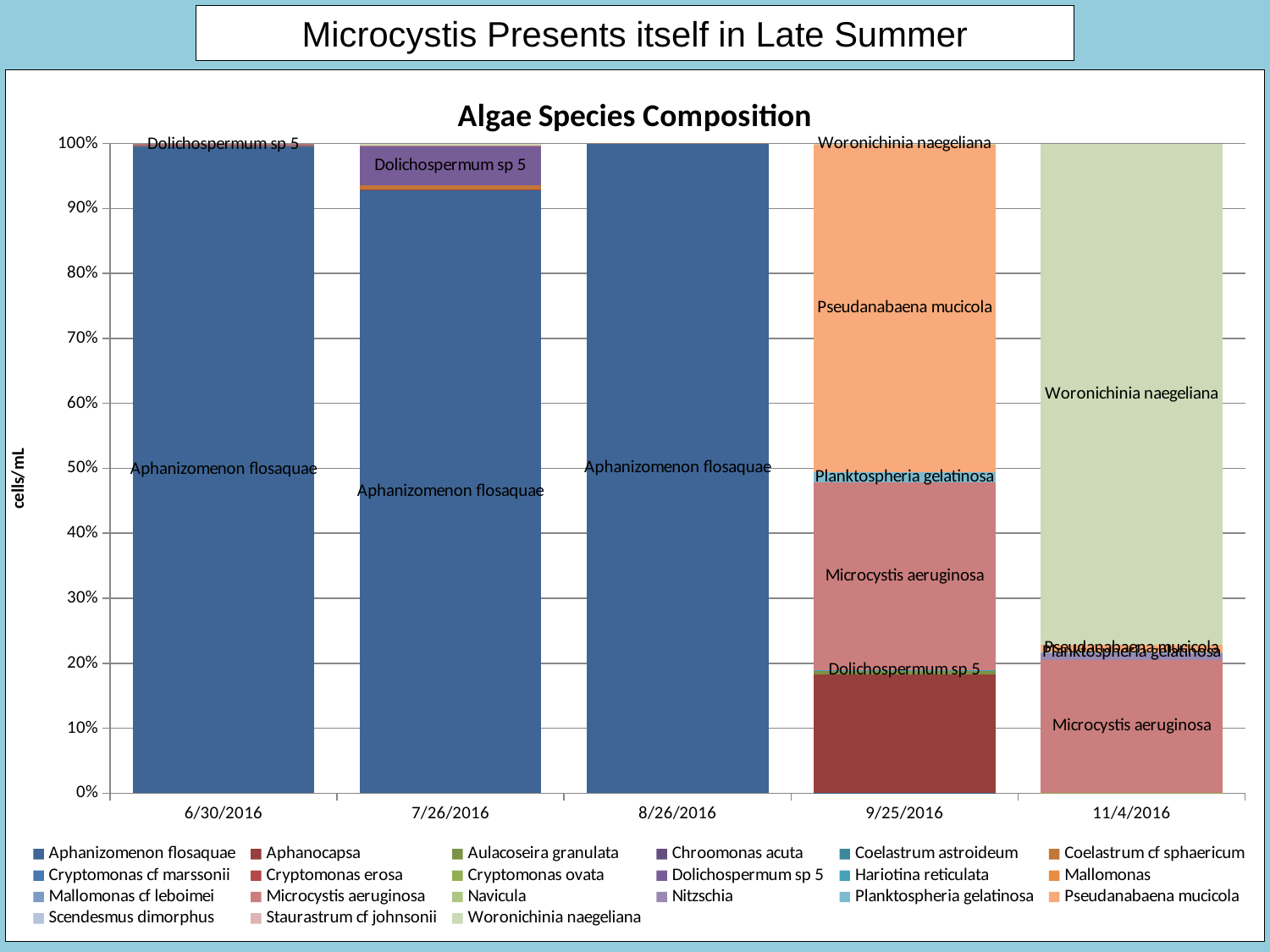
What is the title of the chart? Algae Species Composition How many species does the chart legend list? 21 Is the share of Woronichinia naegeliana on 11/4/2016 greater or less than 70%? greater Which species makes up the largest share of the bar for 8/26/2016? Aphanizomenon flosaquae What is the label on the y axis of the chart? cells/mL Which species makes up the largest share of the bar for 11/4/2016? Woronichinia naegeliana Is the share of Aphanizomenon flosaquae on 6/30/2016 greater or less than 90%? greater How many sampling dates are shown on the x axis of the chart? 5 Is the share of Dolichospermum sp 5 on 7/26/2016 greater or less than 10%? less What kind of chart is shown on the slide? Stacked bar chart On 9/25/2016, which has the larger share: Pseudanabaena mucicola or Microcystis aeruginosa? Pseudanabaena mucicola